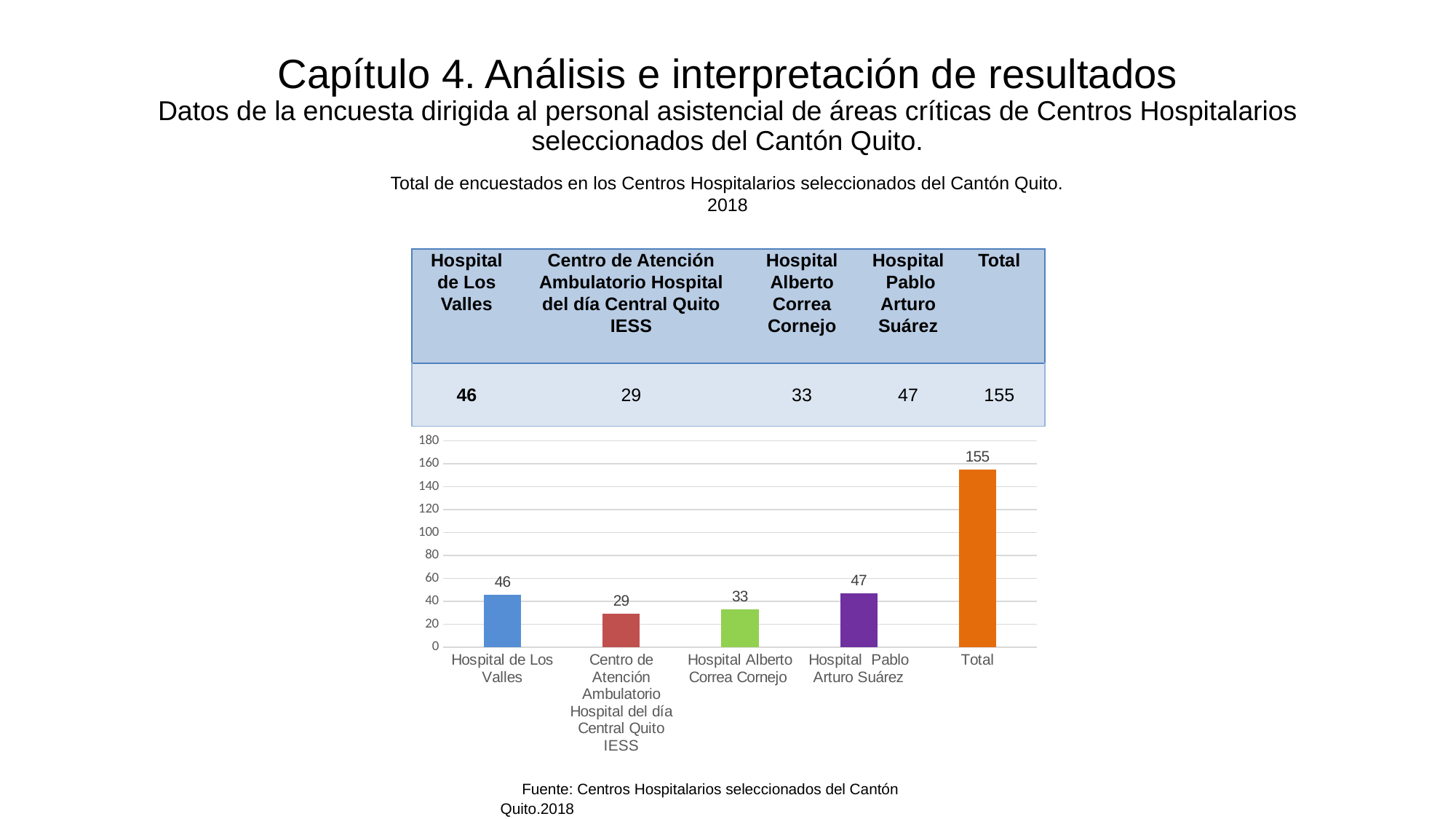
Excluding the Total bar, which hospital has the highest number of respondents? Hospital Pablo Arturo Suárez What is the value for Centro de Atención Ambulatorio Hospital del día Central Quito IESS? 29 How many bars are shown in the chart? 5 What type of chart is shown on the slide? Bar chart What colour is the Total bar? Orange Which is larger, the value for Hospital de Los Valles or for Centro de Atención Ambulatorio Hospital del día Central Quito IESS? Hospital de Los Valles Which hospital has the lowest number of respondents? Centro de Atención Ambulatorio Hospital del día Central Quito IESS What is the difference between Hospital de Los Valles and Hospital Alberto Correa Cornejo? 13 What is the value for Hospital Pablo Arturo Suárez? 47 What is the value for Hospital Alberto Correa Cornejo? 33 What is the value of the Total bar? 155 What is the value for Hospital de Los Valles? 46